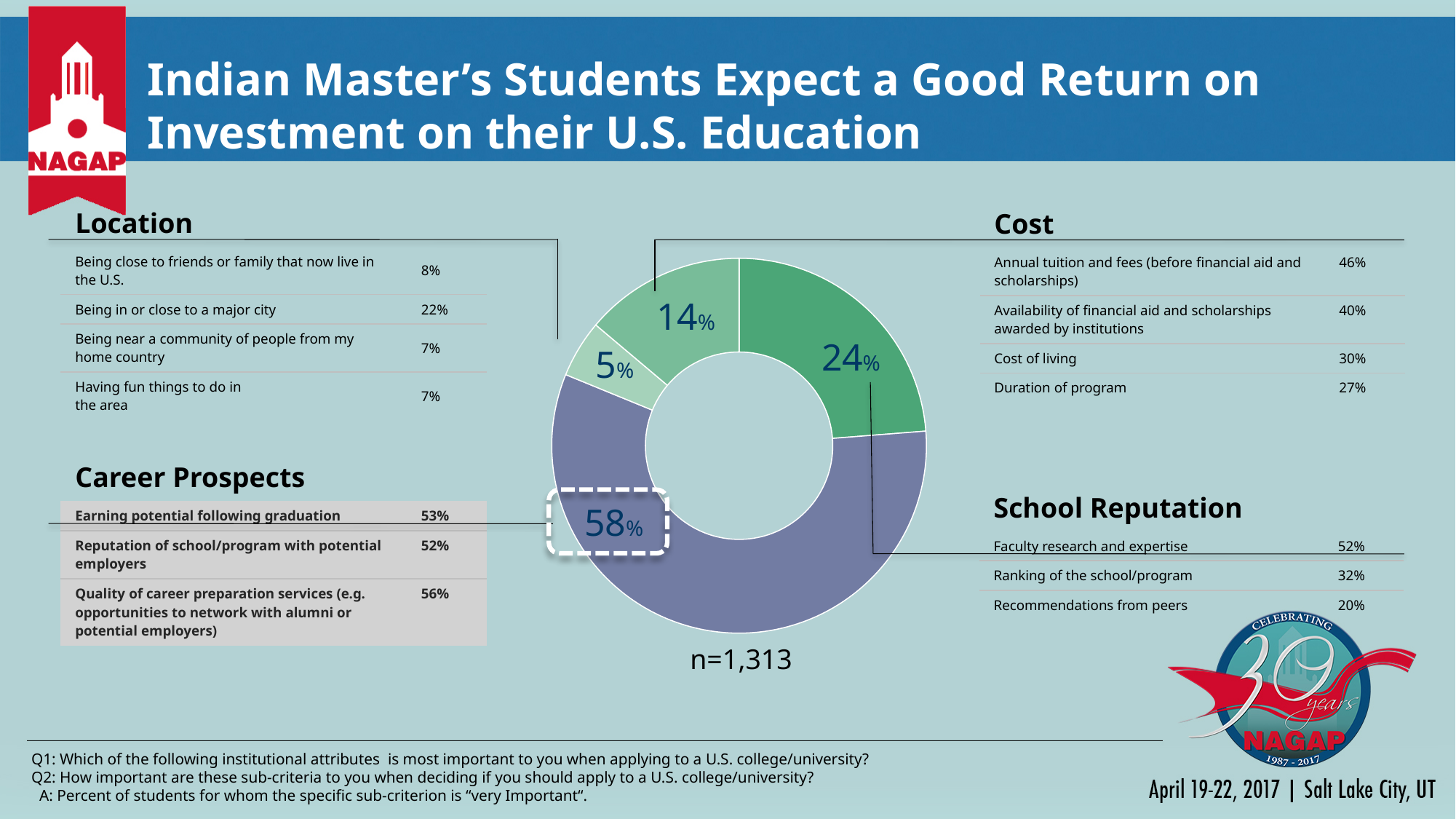
Which is larger in the donut chart, the 14% slice or the 5% slice? the 14% slice What sample size (n) is shown below the donut chart? n=1,313 What is the title of the slide containing the donut chart? Indian Master's Students Expect a Good Return on Investment on their U.S. Education What share of the donut chart is linked to Career Prospects? 58% How many slices does the donut chart have? 4 What kind of chart is shown in the centre of the slide? pie chart (donut) What share of the donut chart is linked to School Reputation? 24% What is the difference between the 58% slice and the 24% slice in the donut chart? 34 percentage points What is the difference between the 24% slice and the 14% slice in the donut chart? 10 percentage points What do the 14% and 5% slices of the donut chart add up to? 19% What is the value of the largest slice in the donut chart? 58% What is the value of the smallest slice in the donut chart? 5%